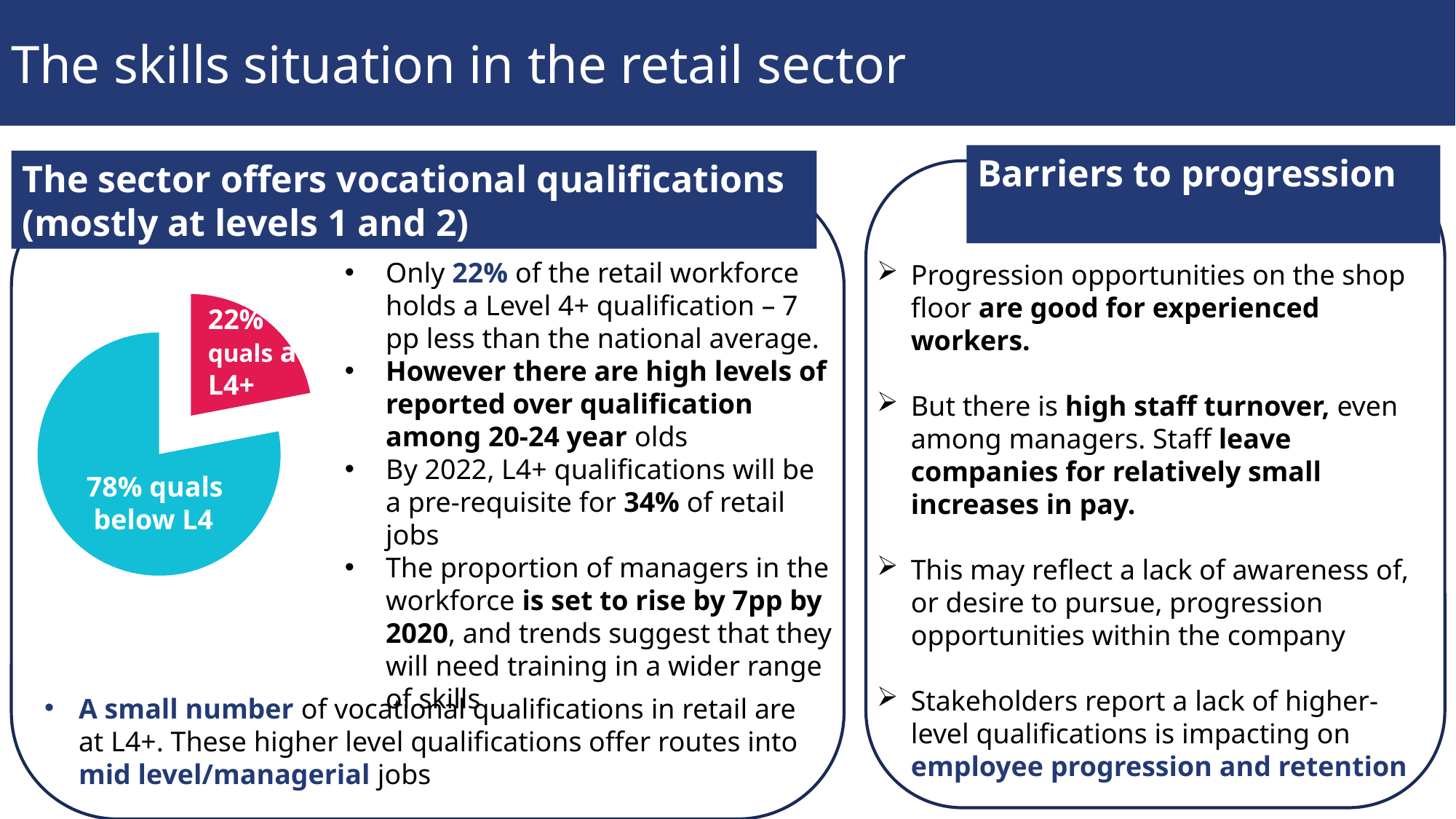
Which is larger in the pie chart: the share with quals at L4+ or the share with quals below L4? quals below L4 What colour is the slice representing 22% quals at L4+? pink/red What share of the pie chart represents qualifications below L4? 78% What share of the pie chart represents qualifications at L4+? 22% What kind of chart is shown on the slide? pie chart Which slice of the pie chart is the largest? 78% quals below L4 Which slice of the pie chart is the smallest? 22% quals at L4+ What is the total of the two slices shown in the pie chart? 100% What colour is the slice representing 78% quals below L4? cyan/light blue What is the difference in percentage points between the 'quals below L4' slice and the 'quals at L4+' slice? 56 How many slices does the pie chart have? 2 Is the share of the workforce with quals at L4+ greater or less than 50%? less